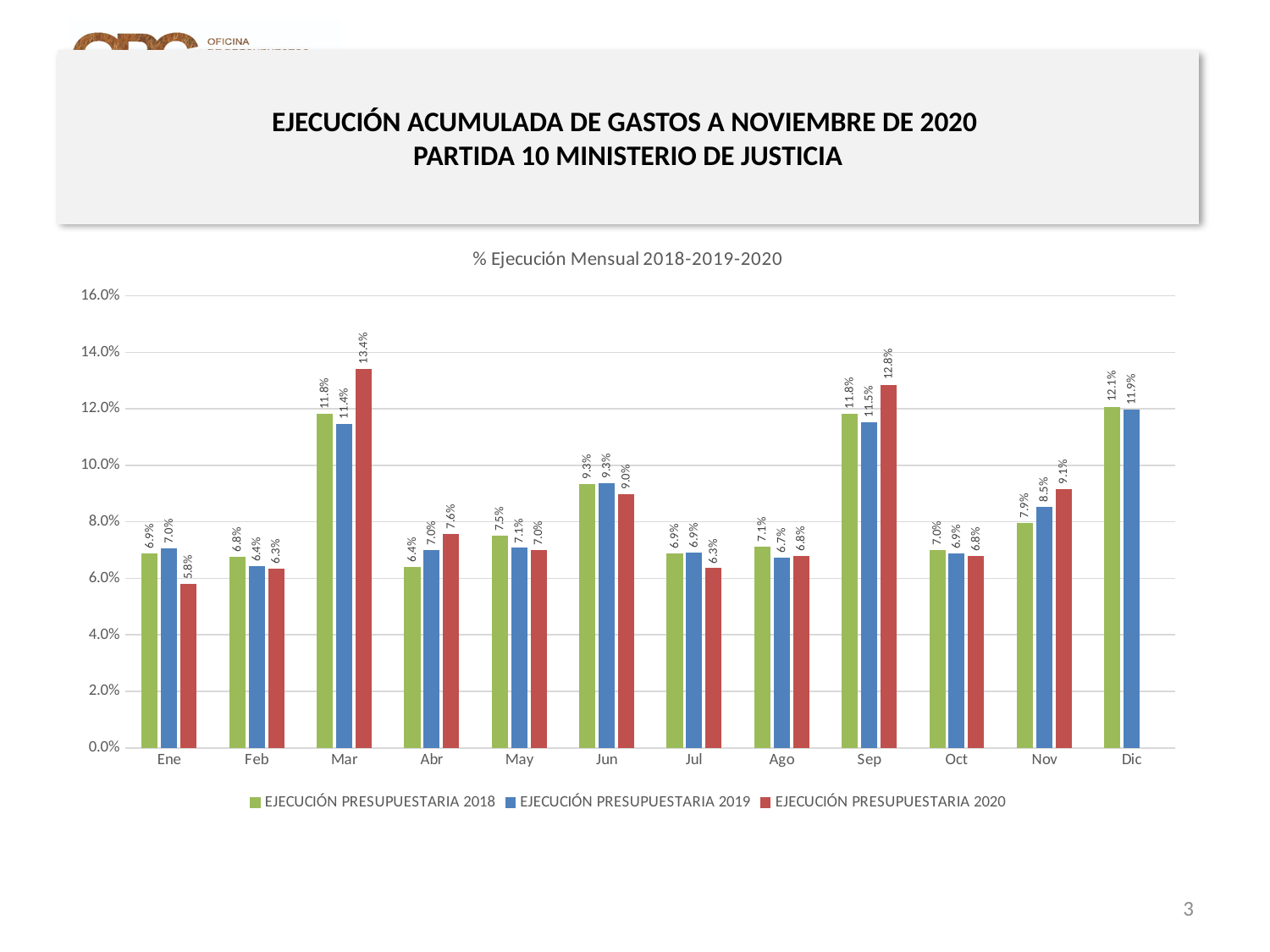
How many series does the legend list? 3 Which is larger in Abr: the 2018 value or the 2020 value? 2020 What is the value for EJECUCIÓN PRESUPUESTARIA 2019 in Nov? 8.5% In which month is the EJECUCIÓN PRESUPUESTARIA 2020 value highest? Mar What is the title of the chart? % Ejecución Mensual 2018-2019-2020 Is the value for EJECUCIÓN PRESUPUESTARIA 2019 in Jun greater or less than 8.0%? greater In which month is the EJECUCIÓN PRESUPUESTARIA 2020 value lowest? Ene What is the value for EJECUCIÓN PRESUPUESTARIA 2018 in Dic? 12.1% What is the value for EJECUCIÓN PRESUPUESTARIA 2020 in Mar? 13.4% What type of chart is shown on the slide? bar chart What is the difference between the 2020 and 2018 values in Sep? 1.0% How many months are shown on the x axis? 12